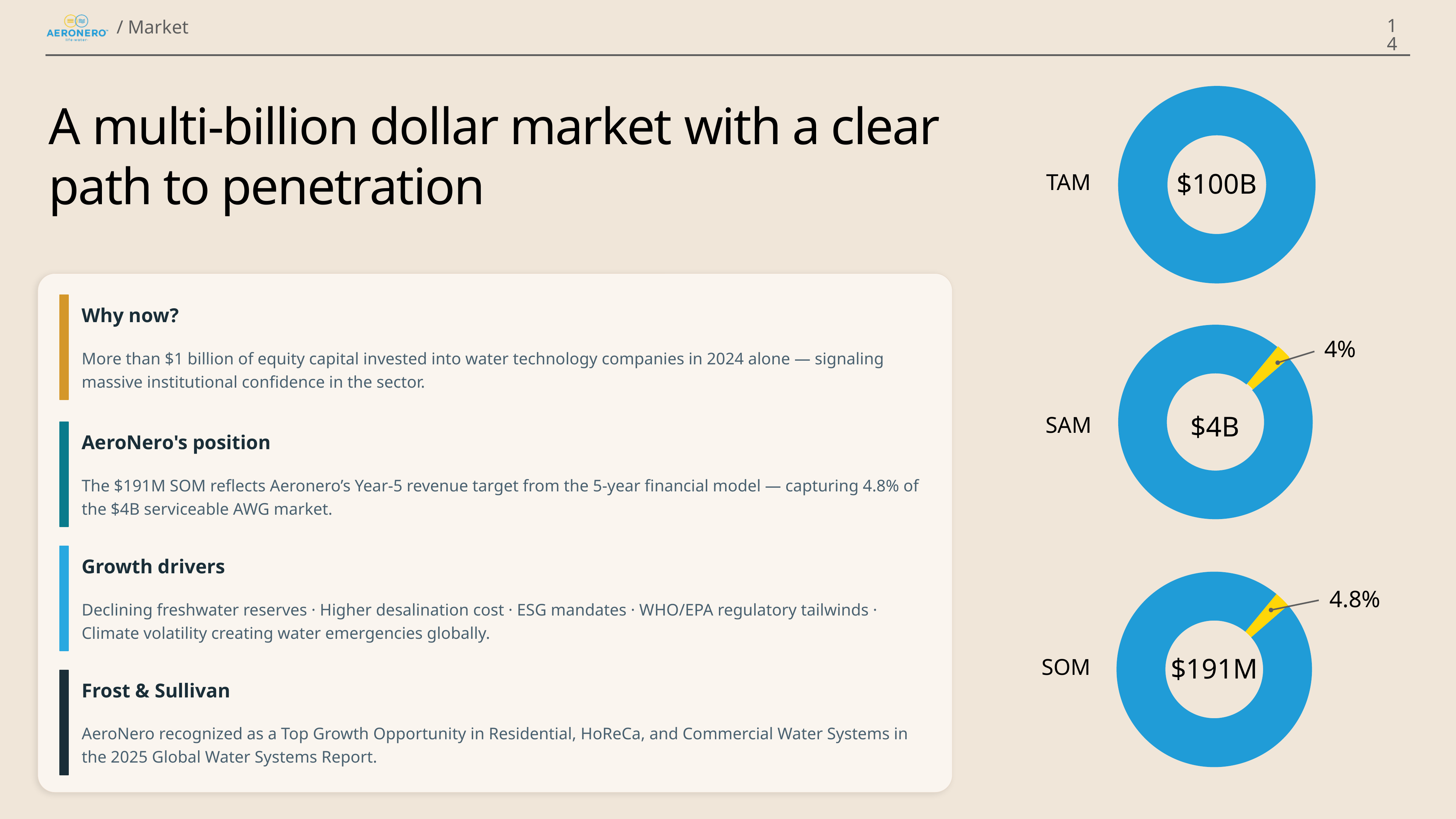
What colour is the small highlighted slice in the SAM and SOM donut charts? Yellow How many donut charts are on the slide? 3 What kind of charts are shown on the right side of the slide? Donut charts Which of the three donut charts (TAM, SAM, SOM) shows the smallest market value? SOM In the SOM donut chart, what percentage is labelled on the yellow slice? 4.8% What value is shown in the centre of the SAM donut chart? $4B Which of the three donut charts (TAM, SAM, SOM) shows the largest market value? TAM Which donut chart has the larger labelled yellow slice, SAM or SOM? SOM In the SAM donut chart, what percentage is labelled on the yellow slice? 4% What value is shown in the centre of the SOM donut chart? $191M What value is shown in the centre of the TAM donut chart? $100B What is the difference in percentage points between the yellow slice labels of the SOM and SAM donut charts? 0.8 percentage points